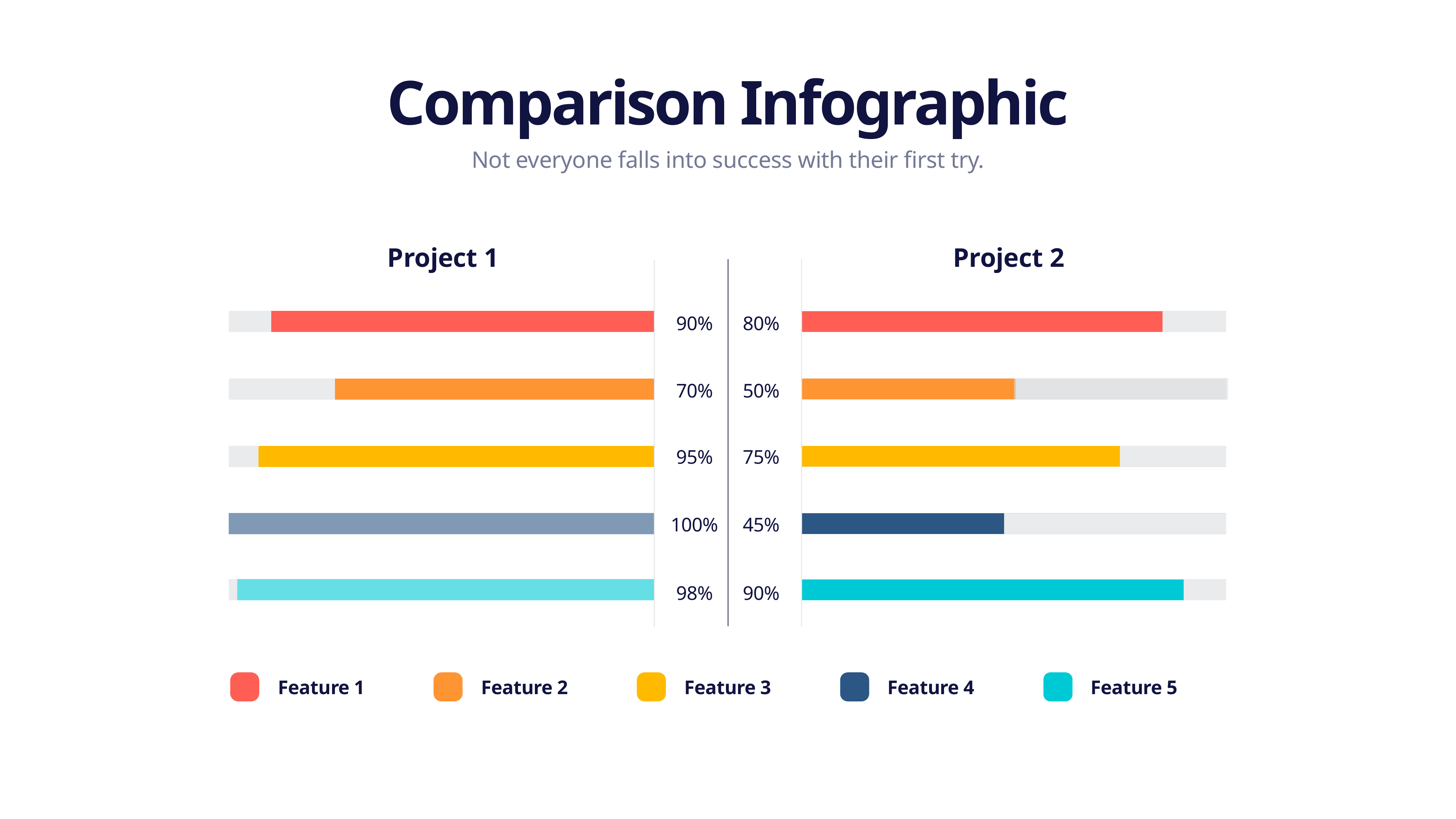
What is the value for Feature 3 in Project 2? 75% What kind of chart is shown on the slide? Bar chart Which is larger: Feature 5 in Project 2 or Feature 1 in Project 2? Feature 5 in Project 2 How many features does the legend list? 5 What is the difference between the Project 1 and Project 2 values for Feature 2? 20% What is the value for Feature 4 in Project 2? 45% Which feature has the lowest value in Project 2? Feature 4 Which feature has the highest value in Project 1? Feature 4 What is the value for Feature 1 in Project 1? 90% What is the value for Feature 5 in Project 1? 98% What is the difference between the Project 1 and Project 2 values for Feature 4? 55% Which feature has the lowest value in Project 1? Feature 2